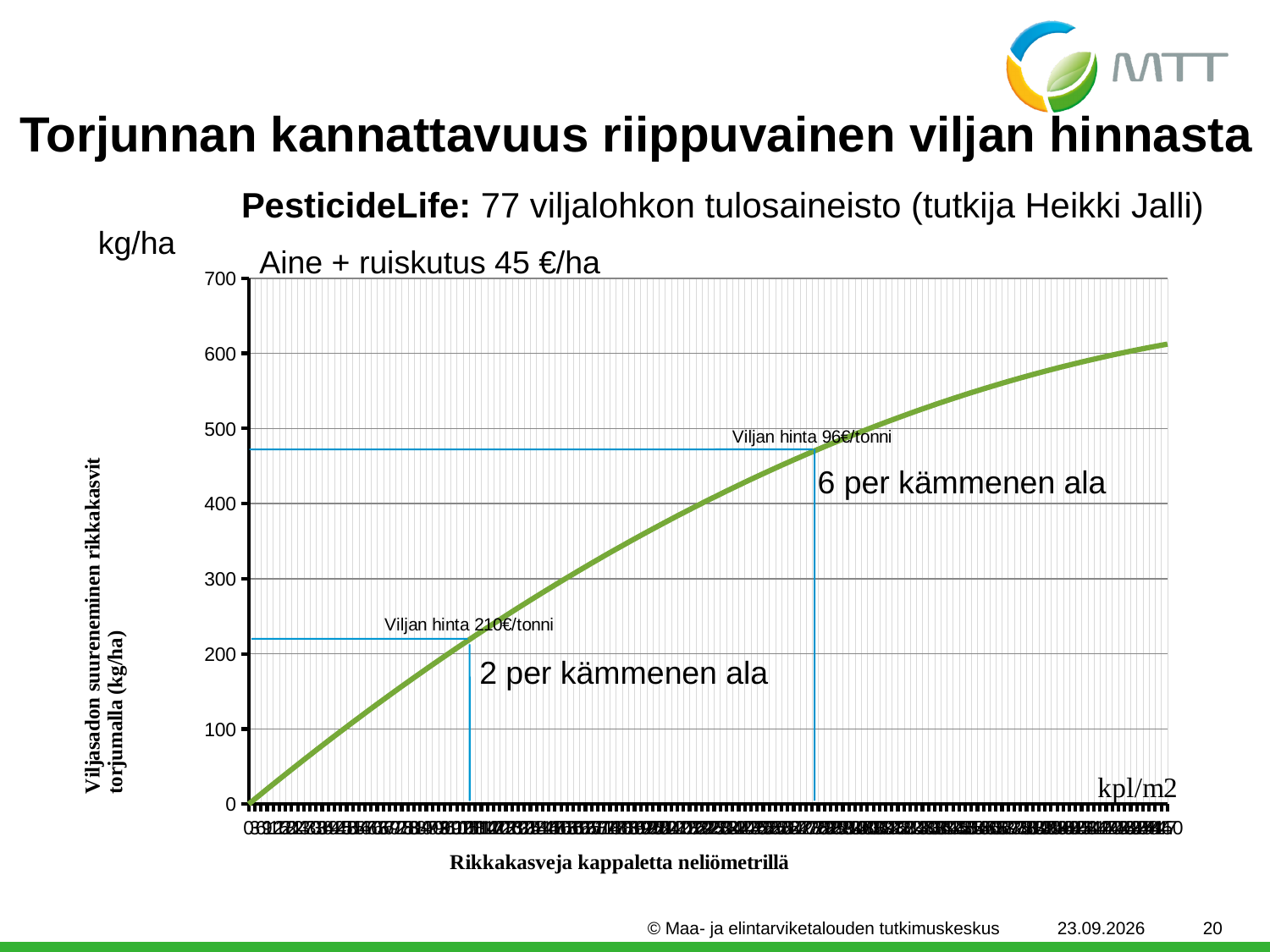
What is the title printed above the chart? Aine + ruiskutus 45 €/ha What is the highest value shown on the y axis of the chart? 700 Which marked point on the curve has the higher yield increase: 'Viljan hinta 96€/tonni' or 'Viljan hinta 210€/tonni'? Viljan hinta 96€/tonni Does the plotted curve rise or fall as the number of weeds per square metre increases along the x axis? rises Is the yield increase at the point marked 'Viljan hinta 96€/tonni' greater or less than 400 kg/ha? greater How many data series (lines) are plotted on the chart? 1 Is the highest value reached by the curve greater or less than 700 kg/ha? less What kind of chart is shown on the slide? line chart Is the yield increase at the point marked 'Viljan hinta 210€/tonni' greater or less than 300 kg/ha? less